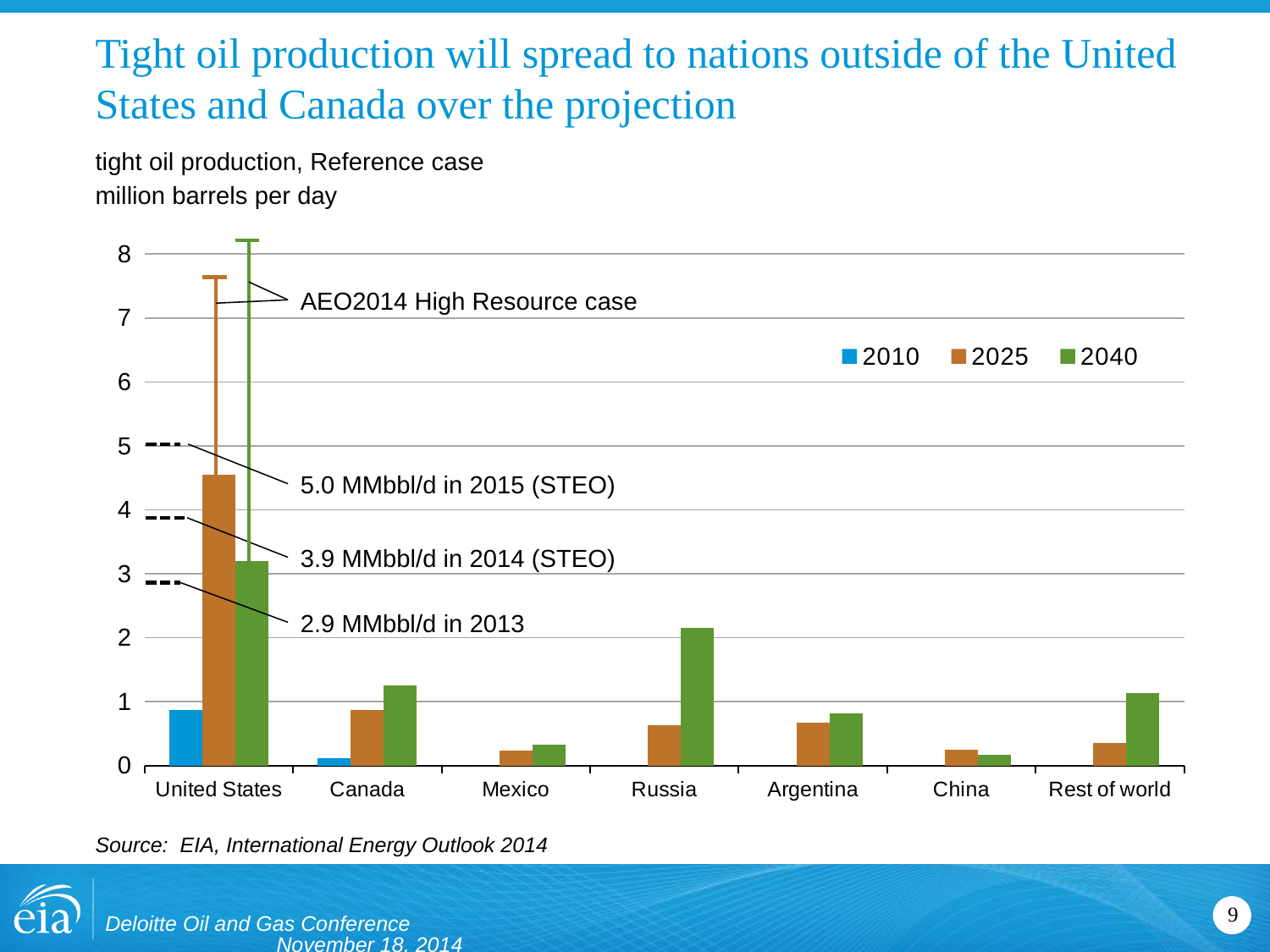
According to the annotation on the chart, what was U.S. tight oil production in 2013? 2.9 MMbbl/d Is the value for Russia in 2040 greater or less than 2? greater Is the value for Canada in 2040 greater or less than 1? greater Which is larger in 2040: tight oil production in Russia or in Canada? Russia What kind of chart is shown on the slide? bar chart Which country or region has the highest tight oil production in 2025? United States How many series does the chart's legend list? 3 What unit of measurement is used for the chart's values? million barrels per day Which country or region has the highest tight oil production in 2040? United States For China, which year has the larger tight oil production: 2025 or 2040? 2025 How many countries or regions are shown on the x axis of the chart? 7 Is the value for the United States in 2025 greater or less than 4? greater